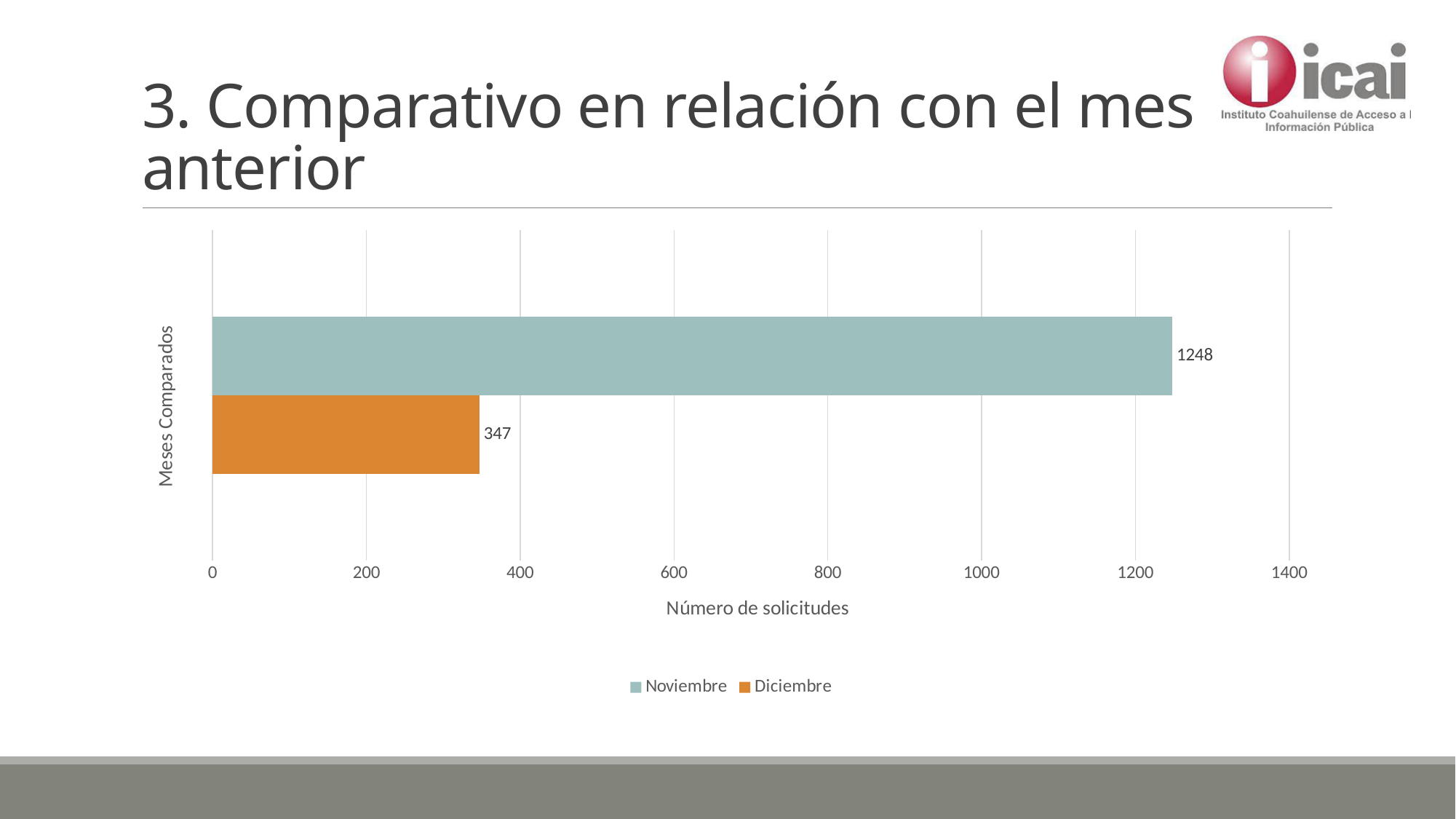
Is the value for Noviembre greater or less than 1200? greater What kind of chart is shown on the slide? bar chart What is the label of the horizontal axis? Número de solicitudes What is the difference between the Noviembre and Diciembre values? 901 What is the label of the vertical axis? Meses Comparados What is the value for Diciembre? 347 Which series has the highest value, Noviembre or Diciembre? Noviembre What is the total of the Noviembre and Diciembre values? 1595 Is the value for Diciembre greater or less than 400? less Which series has the lowest value? Diciembre What is the value for Noviembre? 1248 How many series does the legend list? 2